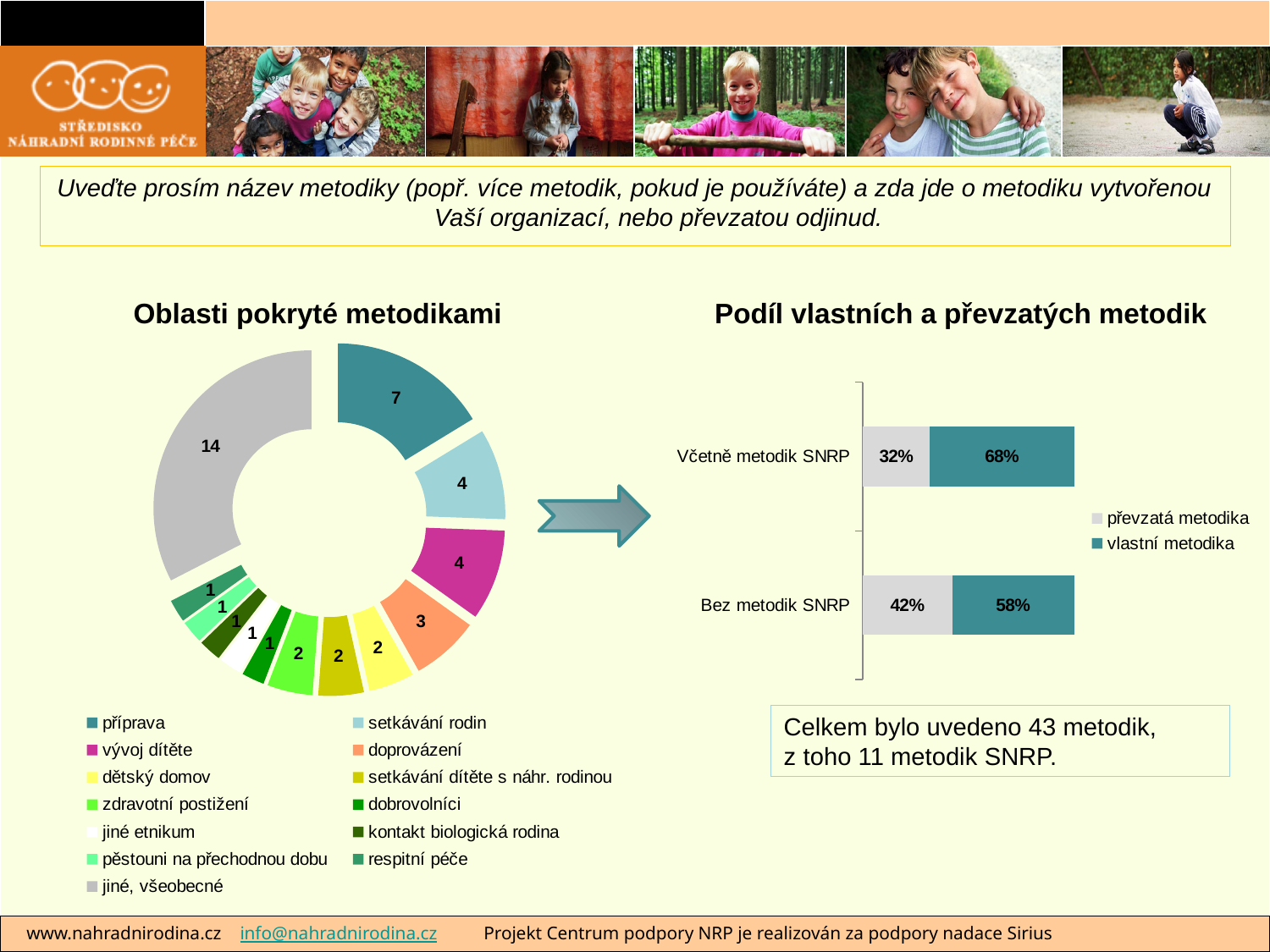
In the chart 'Podíl vlastních a převzatých metodik', what is the difference between the 'vlastní metodika' shares for 'Včetně metodik SNRP' and 'Bez metodik SNRP'? 10% In the chart 'Oblasti pokryté metodikami', what is the value for 'příprava'? 7 In the chart 'Podíl vlastních a převzatých metodik', what is the share of 'převzatá metodika' for 'Bez metodik SNRP'? 42% How many categories does the legend of the chart 'Oblasti pokryté metodikami' list? 13 In the chart 'Podíl vlastních a převzatých metodik', what is the share of 'vlastní metodika' for 'Včetně metodik SNRP'? 68% In the chart 'Oblasti pokryté metodikami', which category has the highest value? jiné, všeobecné How many series does the legend of the chart 'Podíl vlastních a převzatých metodik' list? 2 In the chart 'Oblasti pokryté metodikami', what is the value for 'doprovázení'? 3 In the chart 'Oblasti pokryté metodikami', which is larger: the value for 'příprava' or the value for 'doprovázení'? příprava What kind of chart is 'Oblasti pokryté metodikami'? doughnut chart In the chart 'Oblasti pokryté metodikami', what is the difference between the values for 'jiné, všeobecné' and 'příprava'? 7 In the chart 'Oblasti pokryté metodikami', what is the value for 'jiné, všeobecné'? 14